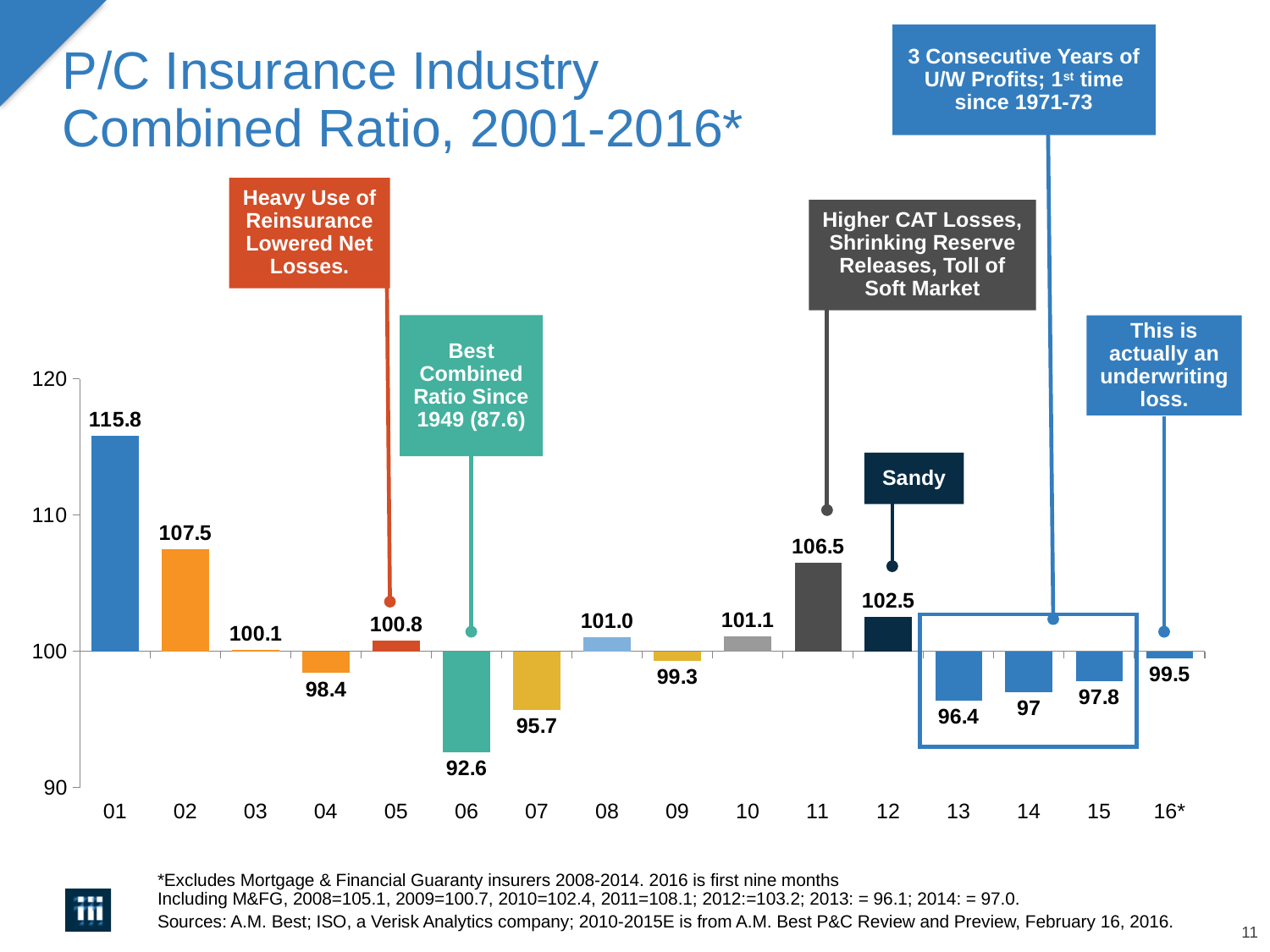
How many years are shown on the x axis? 16 What is the difference between the combined ratio in 2001 and in 2002? 8.3 Which year has the lowest combined ratio? 06 What kind of chart is shown on the slide? bar chart What is the combined ratio for 2012? 102.5 Which year has a higher combined ratio, 2011 or 2012? 11 What is the combined ratio for 2006? 92.6 What is the title of the chart? P/C Insurance Industry Combined Ratio, 2001-2016* Do the combined ratios rise or fall from 2013 to 2015? rise What is the combined ratio for 2001? 115.8 Is the combined ratio for 2007 greater or less than 100? less Which year has the highest combined ratio? 01